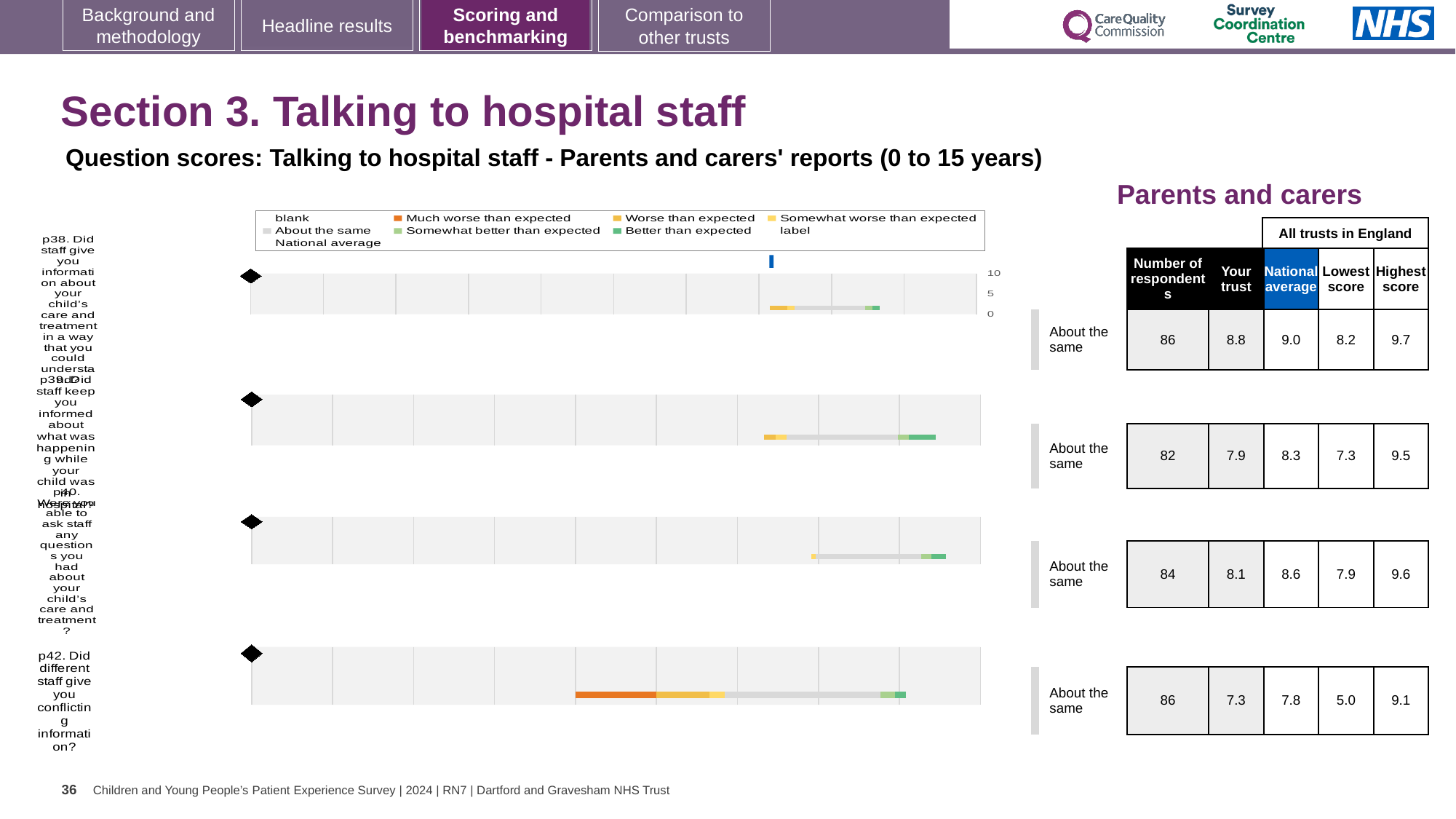
How many survey questions are plotted in the chart? 4 What is the lowest score across all trusts in England for p42? 5.0 What benchmarking category is shown for all four questions? About the same Which question has the lowest 'Your trust' score? p42 What is the 'Your trust' score for p38 (Did staff give you information about your child's care and treatment in a way that you could understand)? 8.8 What is the national average score for p42 (Did different staff give you conflicting information)? 7.8 Which question has the fewest respondents? p39 What kind of chart is used to show the benchmarking results for the four questions? Bar chart Which has the higher 'Your trust' score, p39 or p40? p40 What is the difference between the national average and the 'Your trust' score for p42? 0.5 Which question has the highest 'Your trust' score? p38 How many respondents answered p39 (Did staff keep you informed about what was happening while your child was in hospital)? 82